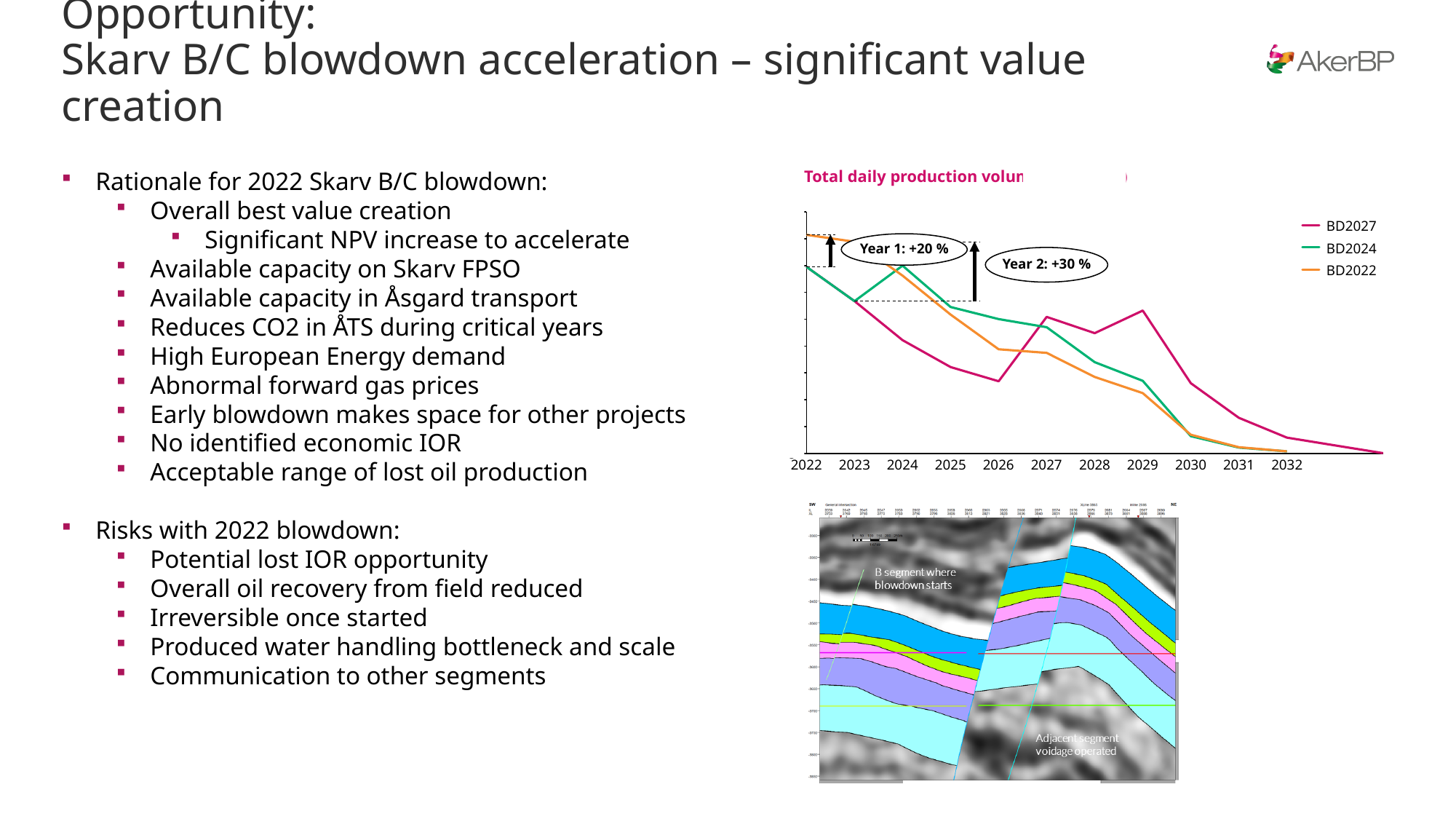
In the line chart, which series has the highest value in 2024? BD2024 How many years are labelled on the x axis of the line chart? 11 What percentage increase does the 'Year 1' annotation on the line chart state? +20 % In the line chart, which series has the lowest value in 2026? BD2027 What kind of chart is shown at the top right of the slide? Line chart In the line chart, which series is higher in 2023, BD2022 or BD2027? BD2022 How many series does the legend of the line chart list? 3 In the line chart, does the BD2022 series generally rise or fall from 2022 to 2032? Fall What is the first year shown on the x axis of the line chart? 2022 What percentage increase does the 'Year 2' annotation on the line chart state? +30 % Which series are listed in the legend of the line chart? BD2027, BD2024, BD2022 In the line chart, which series is higher in 2029, BD2027 or BD2022? BD2027